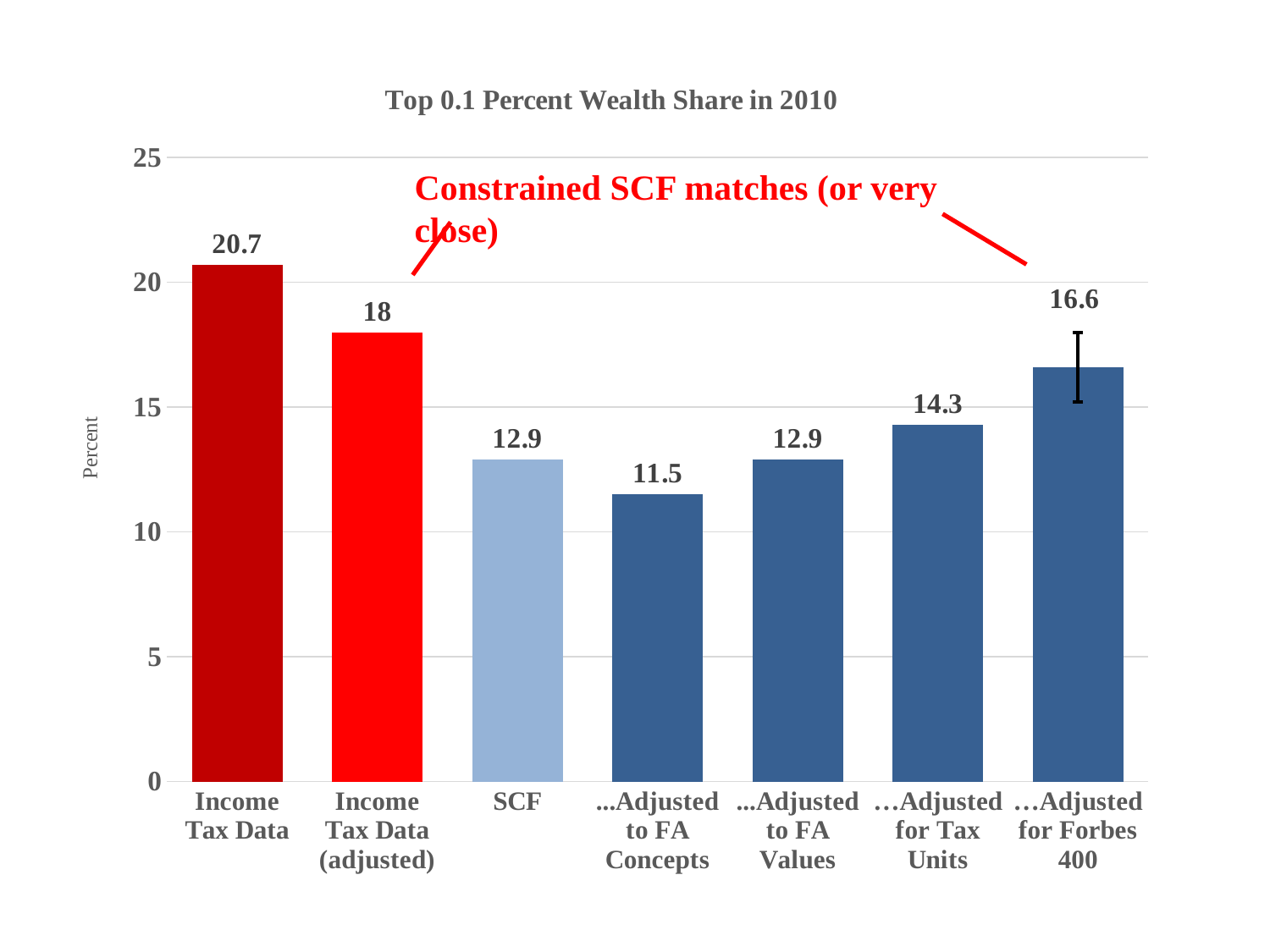
What is the difference between the values for Income Tax Data and Income Tax Data (adjusted)? 2.7 Which is larger, the value for ...Adjusted for Tax Units or the value for ...Adjusted to FA Values? ...Adjusted for Tax Units Which category has the lowest value? ...Adjusted to FA Concepts Which category has the highest value? Income Tax Data What is the value for Income Tax Data? 20.7 What kind of chart is this? bar chart What is the value for SCF? 12.9 How many categories are shown on the x axis? 7 What is the value for ...Adjusted for Forbes 400? 16.6 What is the value for Income Tax Data (adjusted)? 18 Is the value for ...Adjusted to FA Concepts greater or less than 15? less What is the title of the chart? Top 0.1 Percent Wealth Share in 2010